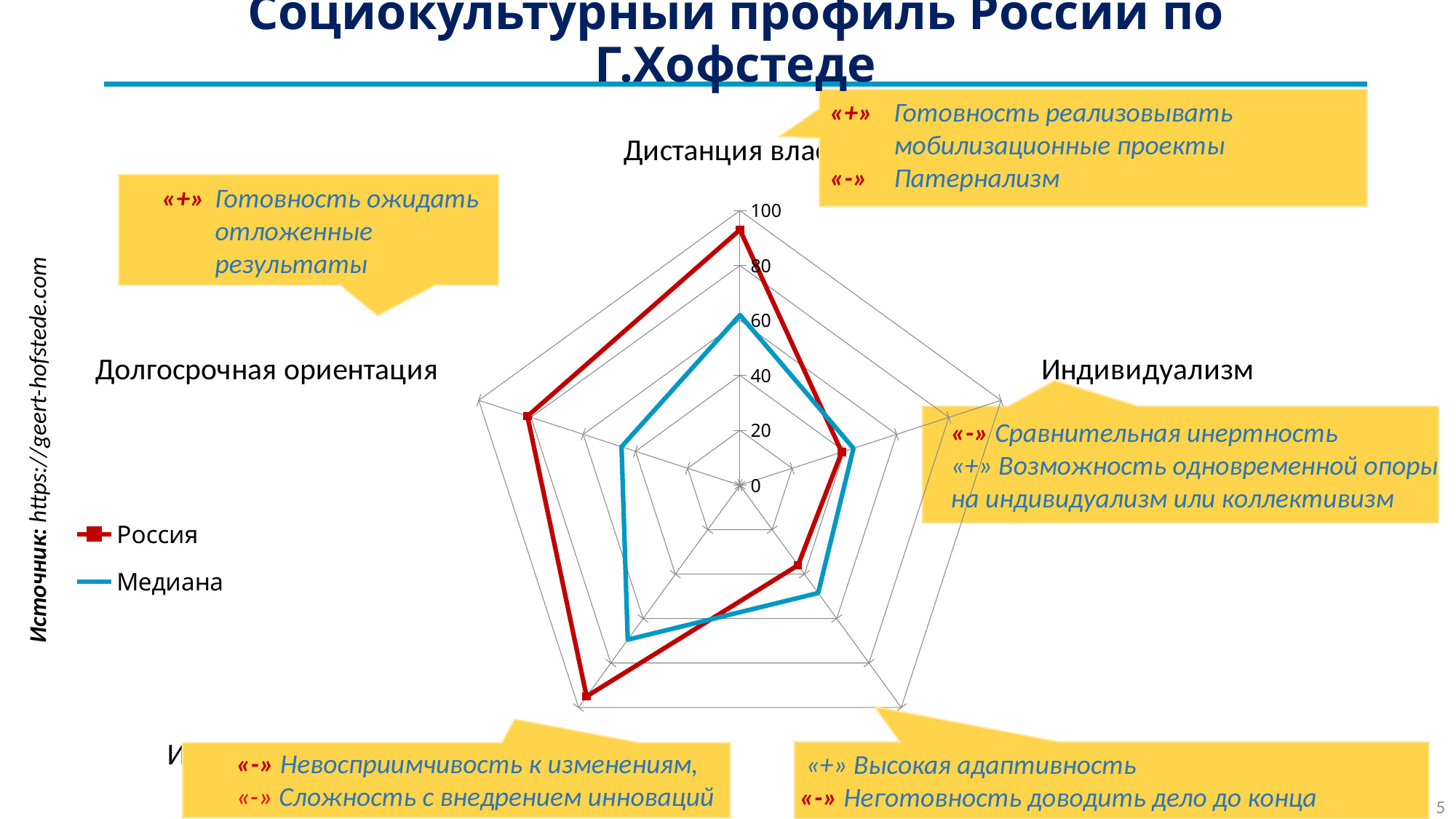
Is the value for Медиана on the Дистанция власти axis greater or less than 80? less On the Долгосрочная ориентация axis, which series has the larger value, Россия or Медиана? Россия Which series are listed in the chart legend? Россия and Медиана Is the value for Россия on the Дистанция власти axis greater or less than 80? greater Is the value for Россия on the Индивидуализм axis greater or less than 60? less How many axes (categories) does the radar chart have? 5 What kind of chart is shown on the slide? Radar chart On the Дистанция власти axis, which series has the larger value, Россия or Медиана? Россия How many series does the chart legend list? 2 What colour is the line for Россия? Red